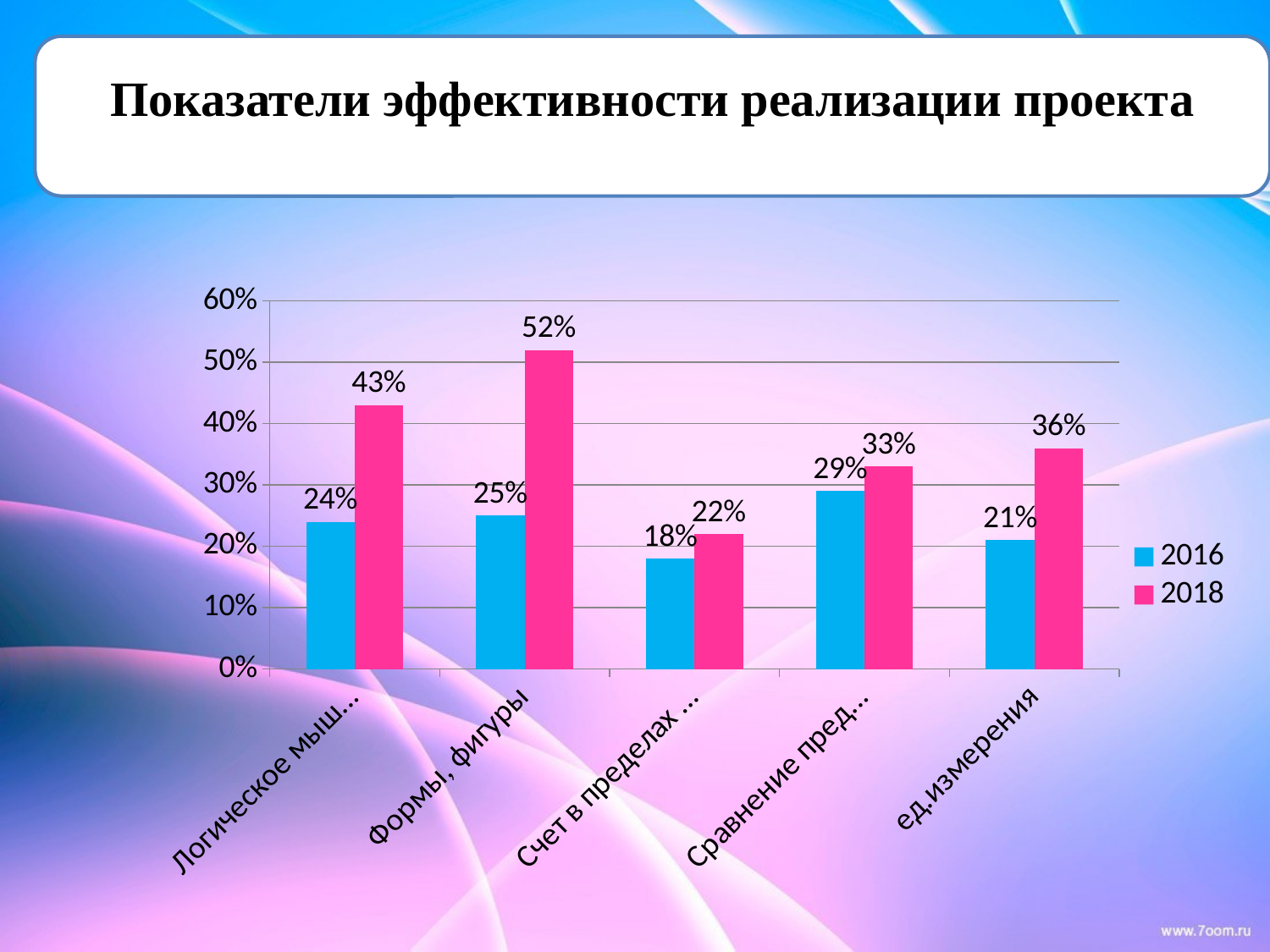
How many categories are shown on the x axis? 5 What is the 2018 value for "Формы, фигуры"? 52% Which category has the highest 2018 value? Формы, фигуры What kind of chart is shown on the slide? Bar chart What is the 2018 value for "ед.измерения"? 36% What is the 2016 value for "ед.измерения"? 21% How many series does the legend list? 2 For "ед.измерения", which year has the larger value, 2016 or 2018? 2018 What is the 2016 value for "Формы, фигуры"? 25% By how many percentage points does the 2018 value for "Формы, фигуры" exceed its 2016 value? 27 percentage points Is the 2018 value for "Формы, фигуры" greater or less than 50%? greater What are the two entries in the chart legend? 2016 and 2018